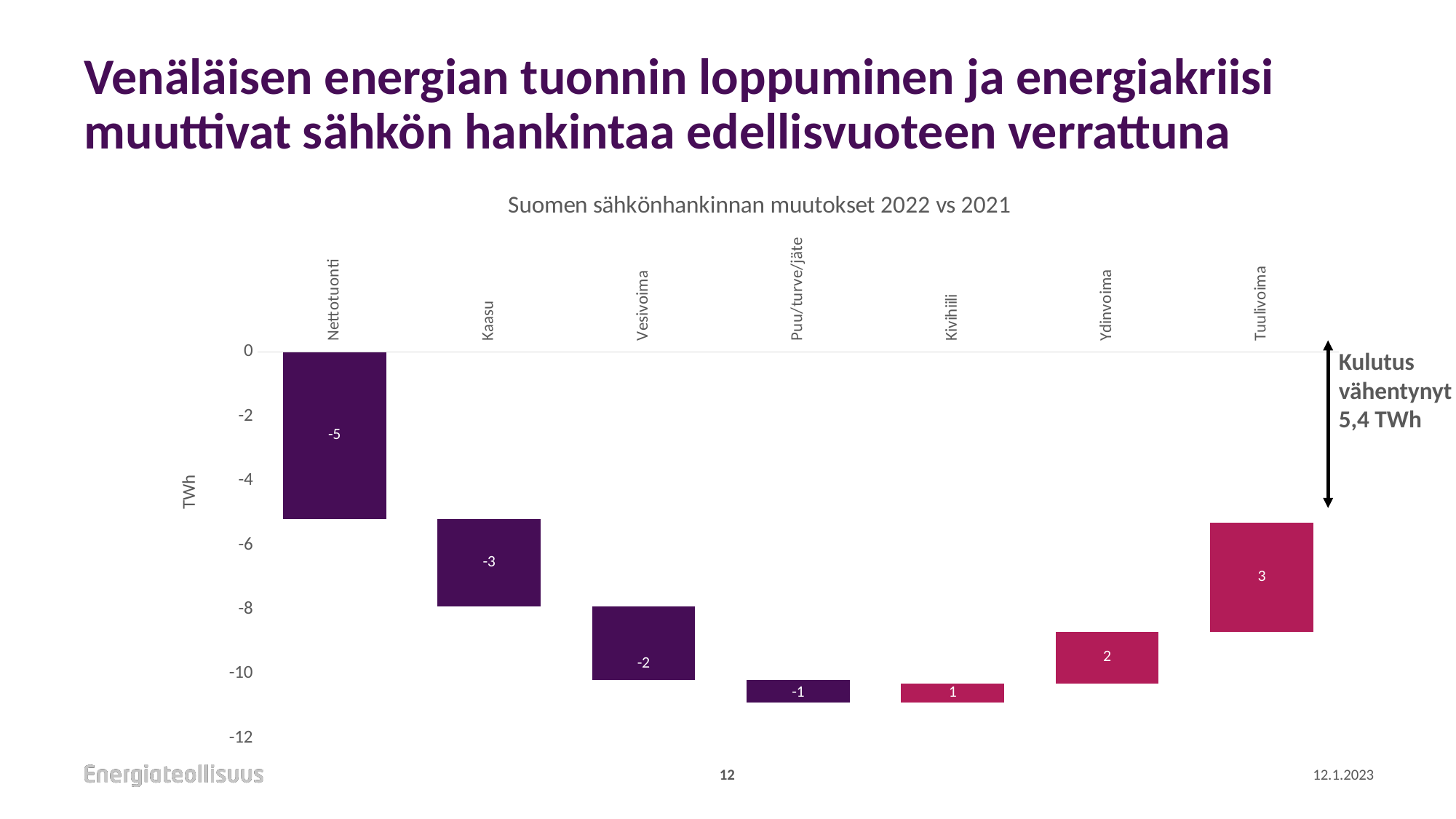
Which has a larger value, Kivihiili or Ydinvoima? Ydinvoima Which category has the largest negative change? Nettotuonti What is the value shown for Puu/turve/jäte? -1 What is the title of the chart? Suomen sähkönhankinnan muutokset 2022 vs 2021 What is the value shown for Ydinvoima? 2 What is the value shown for Nettotuonti? -5 What is the value shown for Kaasu? -3 What is the difference between the values for Tuulivoima and Ydinvoima? 1 What unit is shown on the y axis? TWh How many categories are shown on the x axis? 7 Which category has the largest positive change? Tuulivoima What is the value shown for Tuulivoima? 3